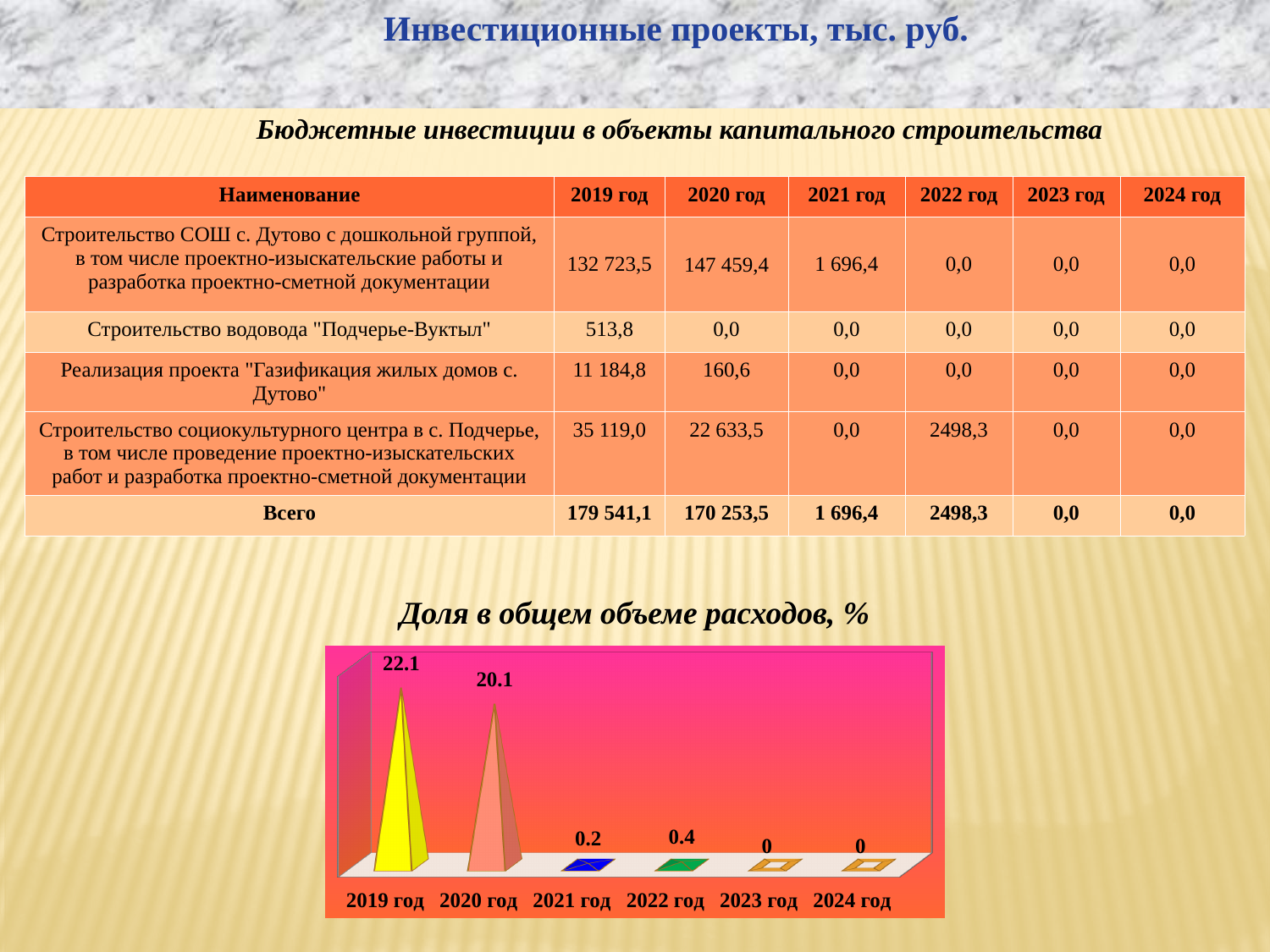
Do the values in the chart "Доля в общем объеме расходов, %" generally rise or fall from 2019 год to 2024 год? fall What is the difference between the values for 2019 год and 2020 год in the chart "Доля в общем объеме расходов, %"? 2.0 What kind of chart is "Доля в общем объеме расходов, %"? bar chart Which year has the highest value in the chart "Доля в общем объеме расходов, %"? 2019 год What is the value for 2021 год in the chart "Доля в общем объеме расходов, %"? 0.2 Which is larger in the chart "Доля в общем объеме расходов, %": the value for 2021 год or 2022 год? 2022 год What is the value for 2022 год in the chart "Доля в общем объеме расходов, %"? 0.4 What is the value for 2019 год in the chart "Доля в общем объеме расходов, %"? 22.1 What is the value for 2020 год in the chart "Доля в общем объеме расходов, %"? 20.1 What is the value for 2023 год in the chart "Доля в общем объеме расходов, %"? 0 What is the title of the chart at the bottom of the slide? Доля в общем объеме расходов, % How many categories are shown on the x axis of the chart "Доля в общем объеме расходов, %"? 6